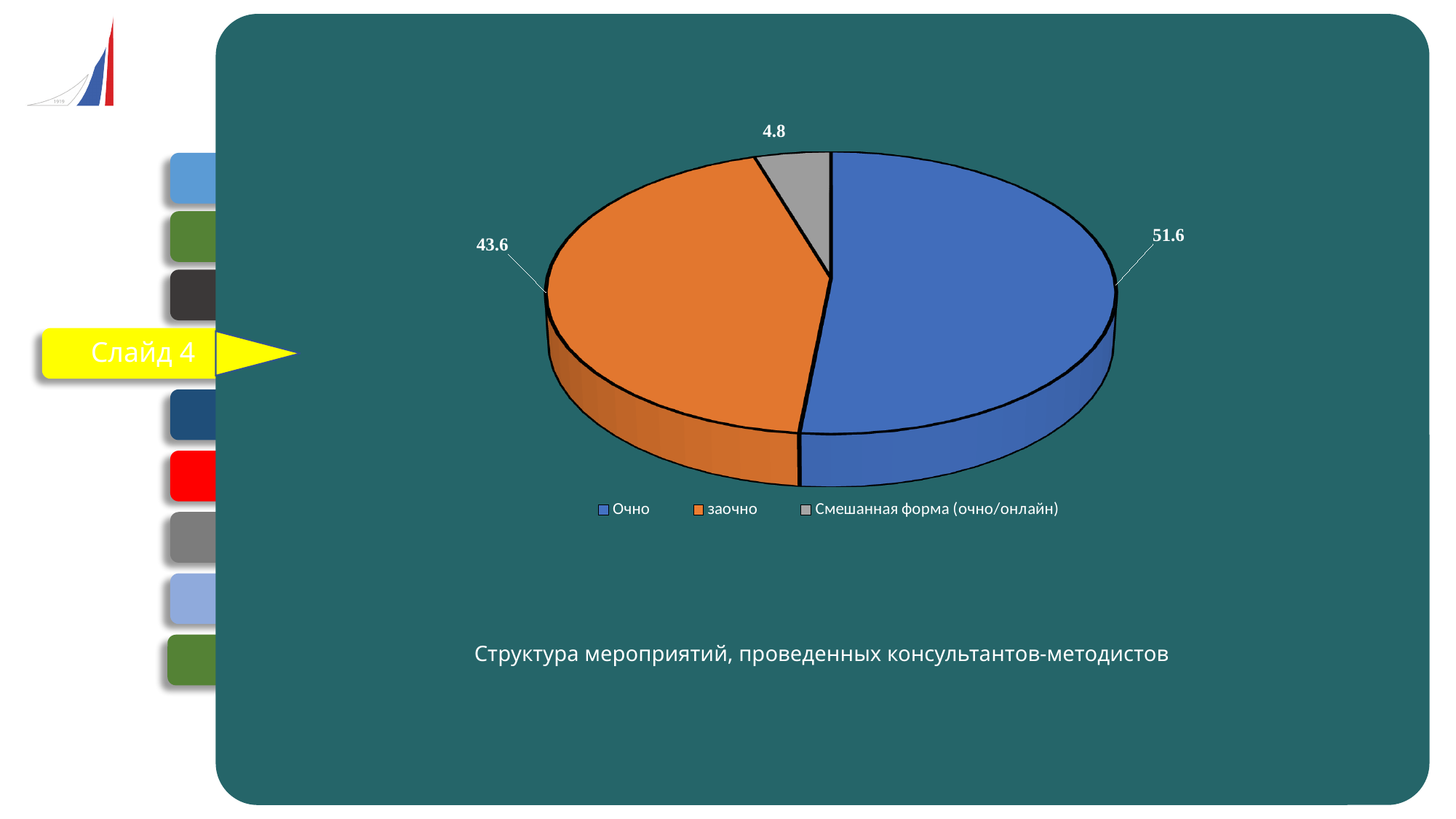
What kind of chart is shown on the slide? Pie chart What is the total of the three values shown on the pie chart? 100 Which category has the smallest slice? Смешанная форма (очно/онлайн) What is the difference between the values for Очно and заочно? 8 What colour is the slice for заочно? Orange How many categories does the pie chart show? 3 Which category has the largest slice? Очно What is the caption below the chart? Структура мероприятий, проведенных консультантов-методистов Which is larger, the value for заочно or the value for Смешанная форма (очно/онлайн)? заочно What is the value for заочно? 43.6 What is the value for Смешанная форма (очно/онлайн)? 4.8 What is the value for Очно? 51.6